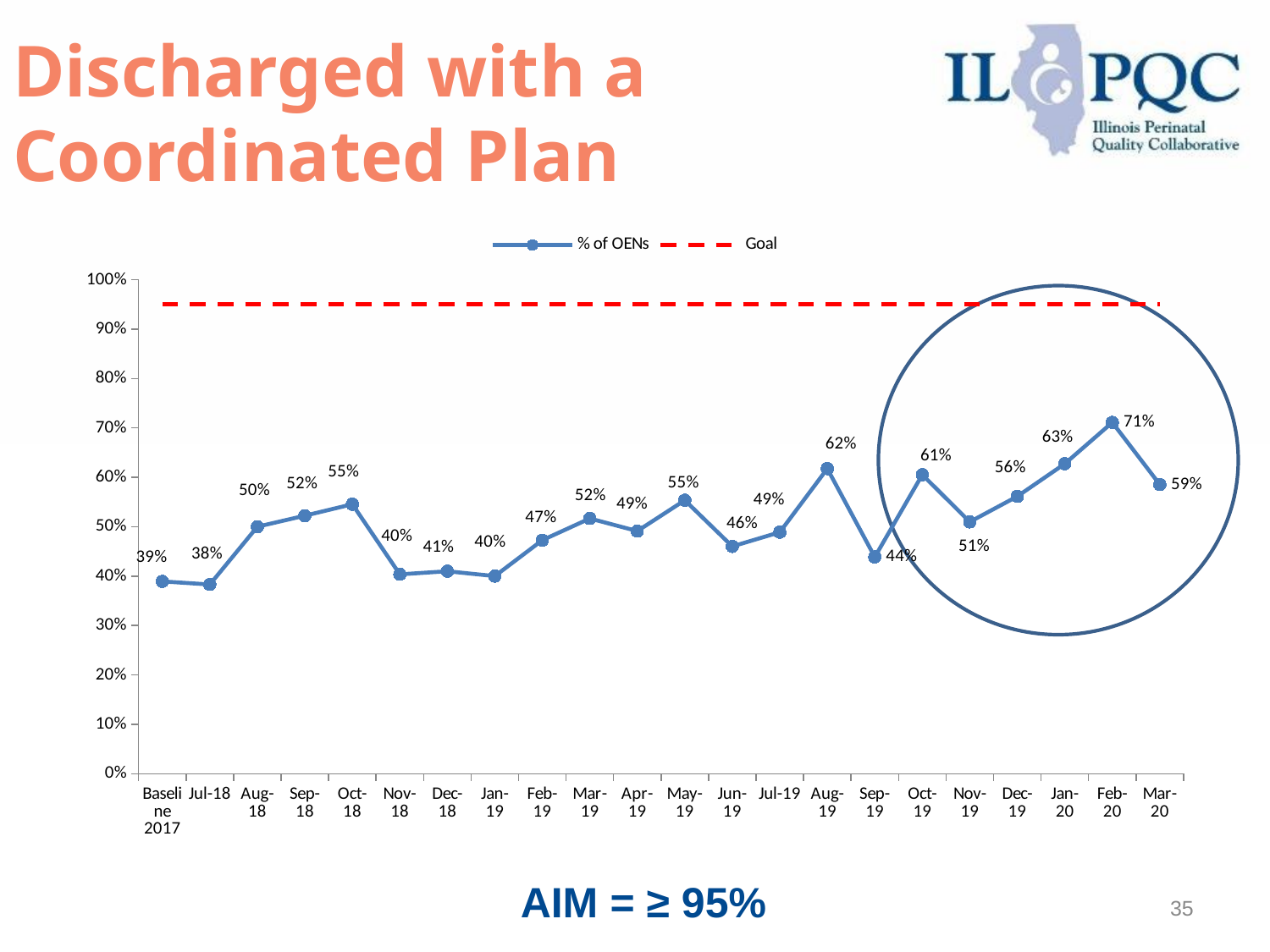
What is the AIM goal stated on the slide? ≥ 95% What is the difference between the values for Feb-20 and Mar-20? 12% Which month has the highest % of OENs? Feb-20 How many data points are plotted on the % of OENs line? 22 Which month has the lowest % of OENs? Jul-18 Which is larger, the value for Oct-18 or the value for Nov-18? Oct-18 What is the value for Aug-19? 62% What kind of chart is shown on the slide? line chart What is the value for Baseline 2017? 39% Is the value for Sep-19 greater or less than 50%? less How many series does the legend list? 2 What is the value for Feb-20? 71%